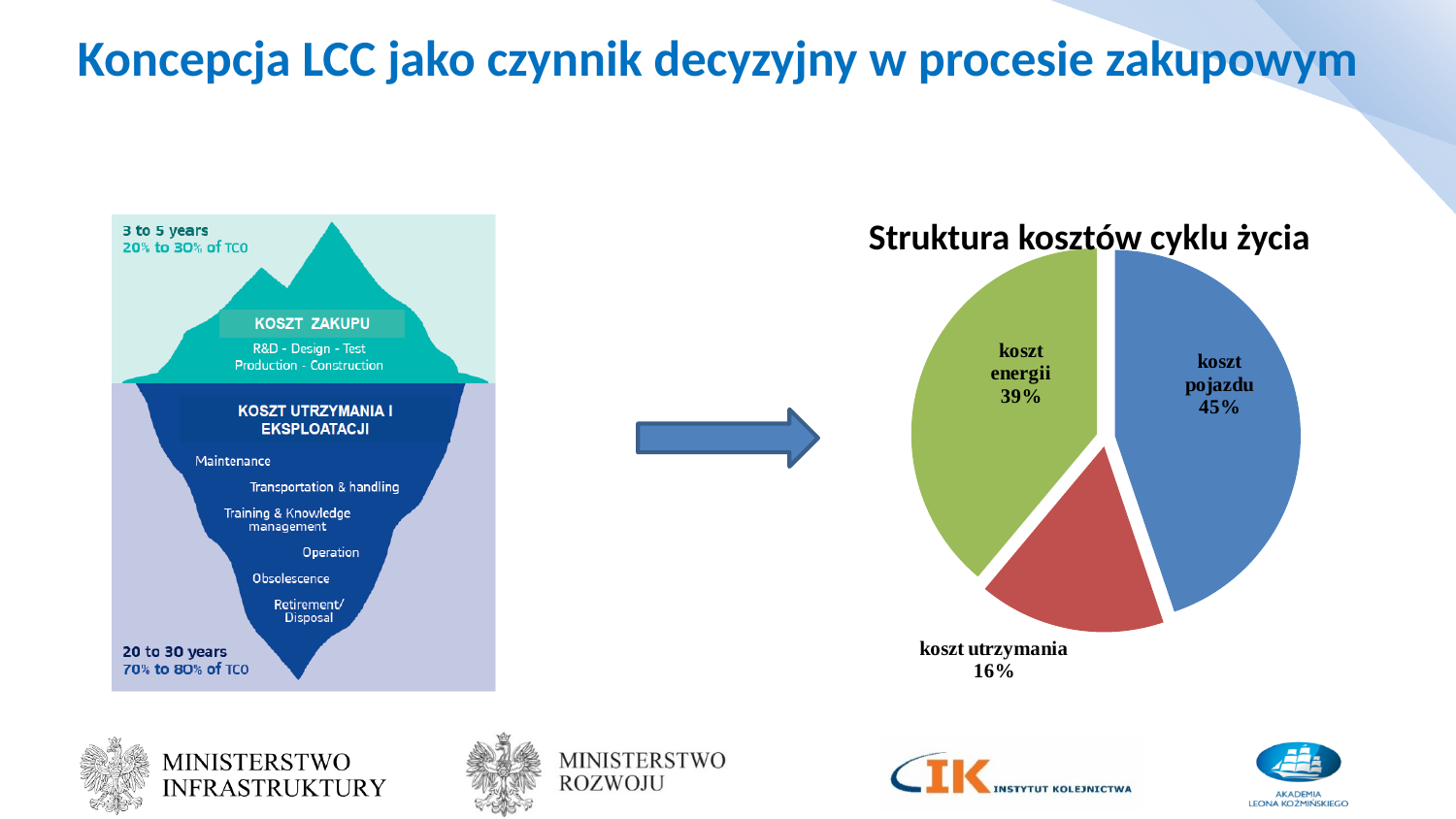
What share of the pie chart 'Struktura kosztów cyklu życia' is 'koszt energii'? 39% In the pie chart 'Struktura kosztów cyklu życia', what is the difference in percentage points between 'koszt pojazdu' and 'koszt utrzymania'? 29 In the pie chart 'Struktura kosztów cyklu życia', which is larger: 'koszt energii' or 'koszt utrzymania'? koszt energii What is the title of the pie chart on the right side of the slide? Struktura kosztów cyklu życia What share of the pie chart 'Struktura kosztów cyklu życia' is 'koszt pojazdu'? 45% In the pie chart 'Struktura kosztów cyklu życia', which is larger: 'koszt pojazdu' or 'koszt energii'? koszt pojazdu How many slices does the pie chart 'Struktura kosztów cyklu życia' have? 3 Which category has the largest slice in the pie chart 'Struktura kosztów cyklu życia'? koszt pojazdu In the pie chart 'Struktura kosztów cyklu życia', what is the difference in percentage points between 'koszt energii' and 'koszt utrzymania'? 23 What kind of chart is 'Struktura kosztów cyklu życia'? pie chart What share of the pie chart 'Struktura kosztów cyklu życia' is 'koszt utrzymania'? 16% Which category has the smallest slice in the pie chart 'Struktura kosztów cyklu życia'? koszt utrzymania